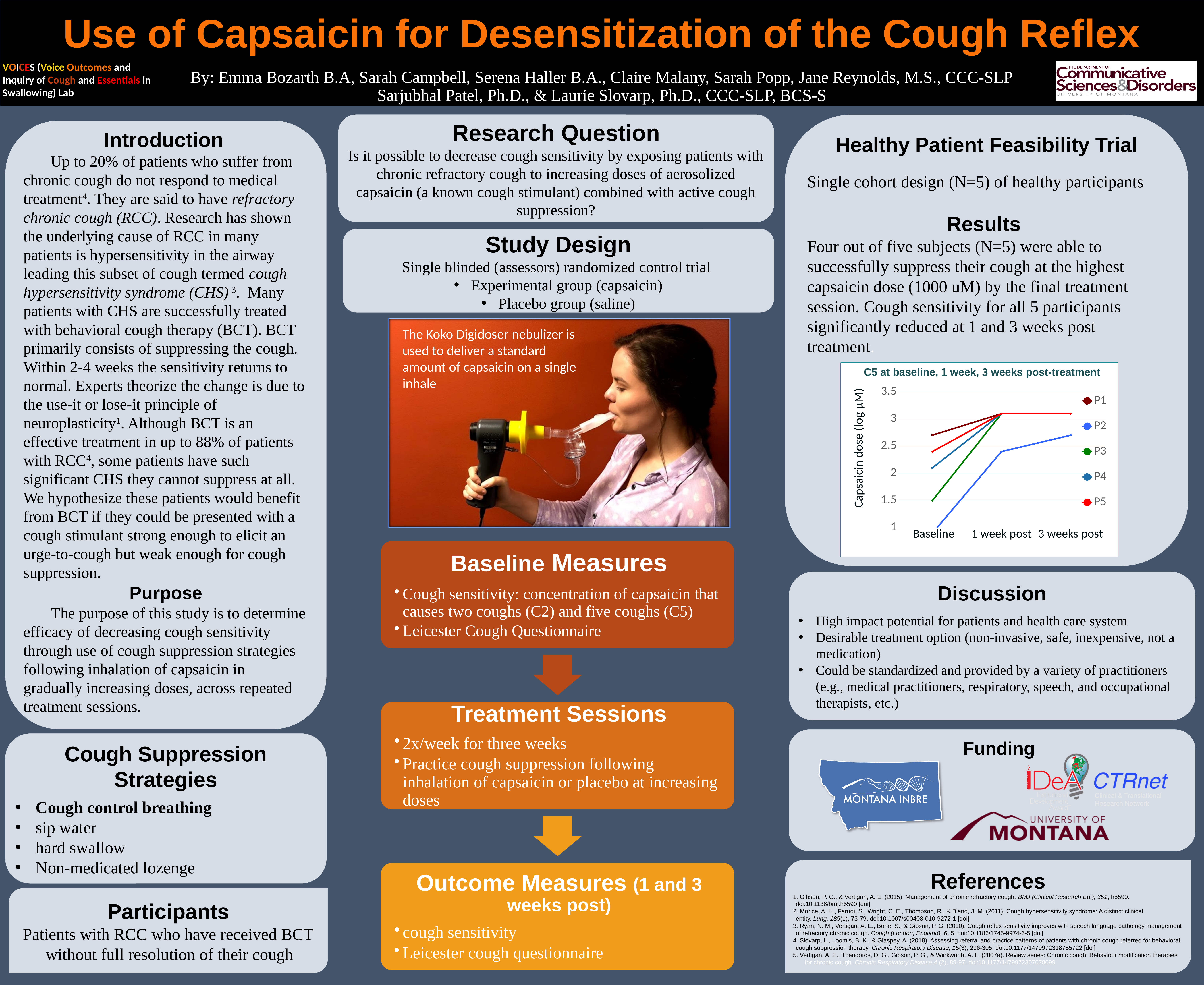
How many series does the legend of the chart list? 5 At Baseline, which is larger, the value for P1 or the value for P3? P1 What is the label of the y axis of the chart? Capsaicin dose (log µM) Is the value for P1 at 1 week post greater or less than 3? greater What kind of chart is shown in the Healthy Patient Feasibility Trial section? line chart How many time points are shown on the x axis of the chart? 3 Which participant has the highest capsaicin dose at Baseline? P1 Do the capsaicin dose values for P2 rise or fall from Baseline to 3 weeks post? rise Which participant has the lowest capsaicin dose at Baseline? P2 Which participant has the lowest capsaicin dose at 3 weeks post? P2 What is the title of the chart? C5 at baseline, 1 week, 3 weeks post-treatment Is the value for P3 at Baseline greater or less than 2? less